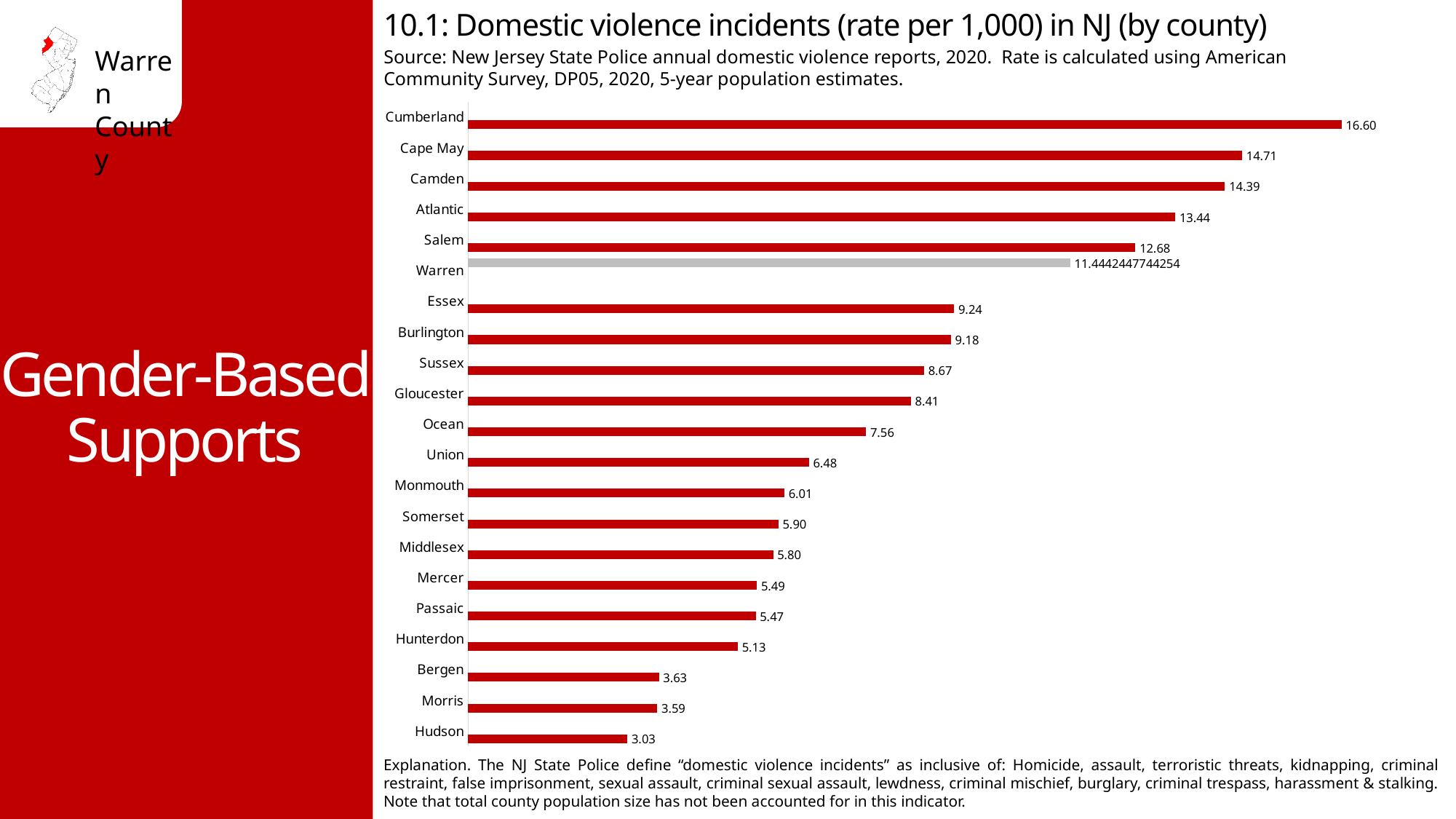
What value is labelled on the Warren bar? 11.4442447744254 Which county has a higher rate, Atlantic or Salem? Atlantic Which county has a higher rate, Essex or Sussex? Essex Which county has the lowest domestic violence incident rate on the chart? Hudson Which county has the highest domestic violence incident rate on the chart? Cumberland What is the rate per 1,000 shown for Ocean County? 7.56 Which county's bar is coloured grey instead of red? Warren What is the difference between the rates for Cumberland and Hudson? 13.57 How many counties are shown on the chart? 21 What is the difference between the rates for Cape May and Camden? 0.32 What is the domestic violence incident rate per 1,000 for Cumberland County? 16.60 What type of chart is used to show the domestic violence incident rates? Bar chart